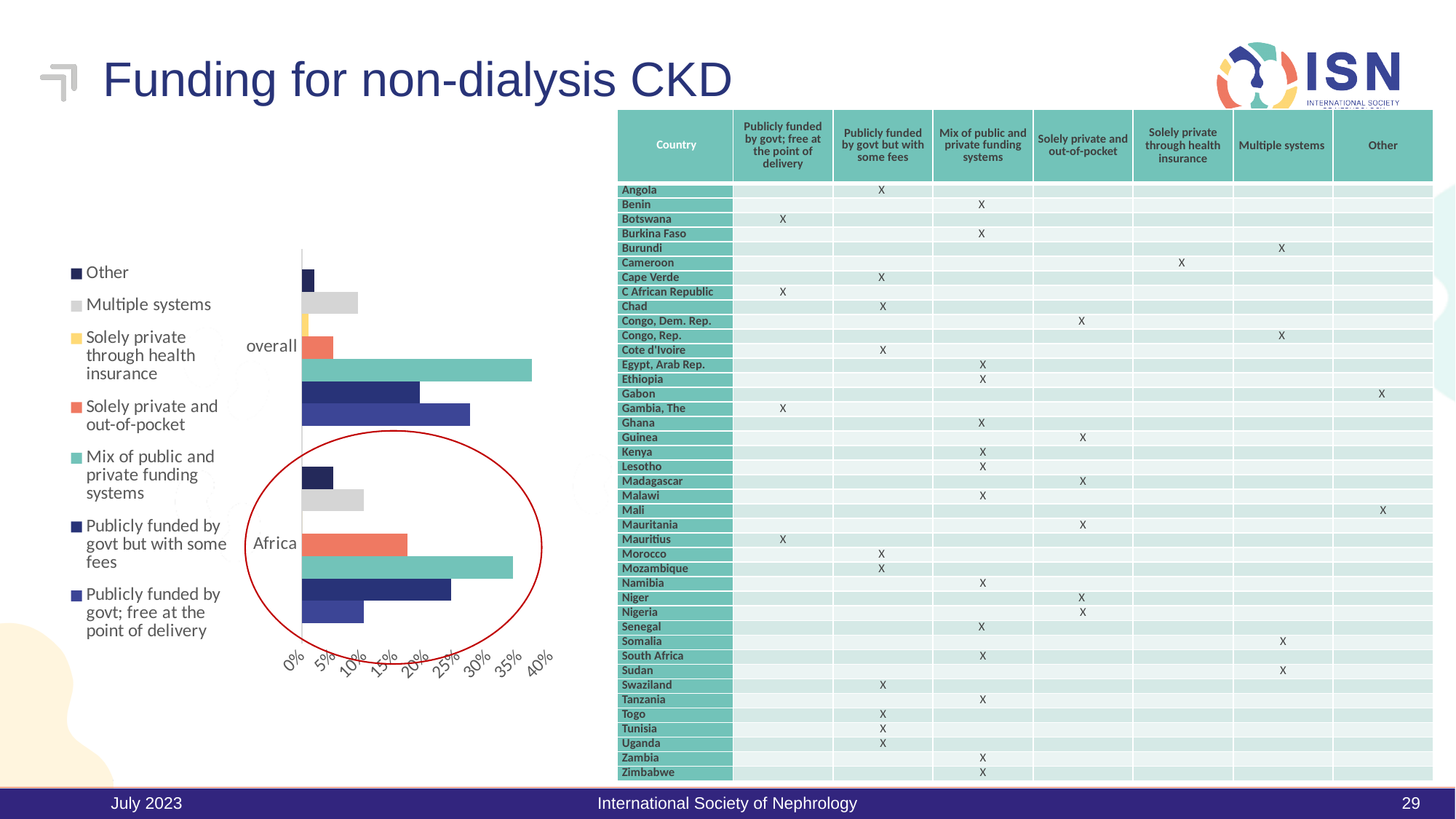
What kind of chart is shown on the slide? bar chart Which funding type has the longest bar for Africa? Mix of public and private funding systems Which funding type has the longest bar for the overall category? Mix of public and private funding systems Which is larger for Publicly funded by govt; free at the point of delivery: the overall value or the Africa value? overall How many series does the chart legend list? 7 How many categories are shown on the chart's vertical axis? 2 Which funding type has the shortest bar for the overall category? Solely private through health insurance Is the value for Solely private and out-of-pocket in Africa greater or less than 10%? greater Is the value for Publicly funded by govt; free at the point of delivery in Africa greater or less than 15%? less Is the value for Mix of public and private funding systems in the overall category greater or less than 35%? greater Which is larger for Solely private and out-of-pocket: the overall value or the Africa value? Africa What is the highest percentage shown on the chart's horizontal axis? 40%